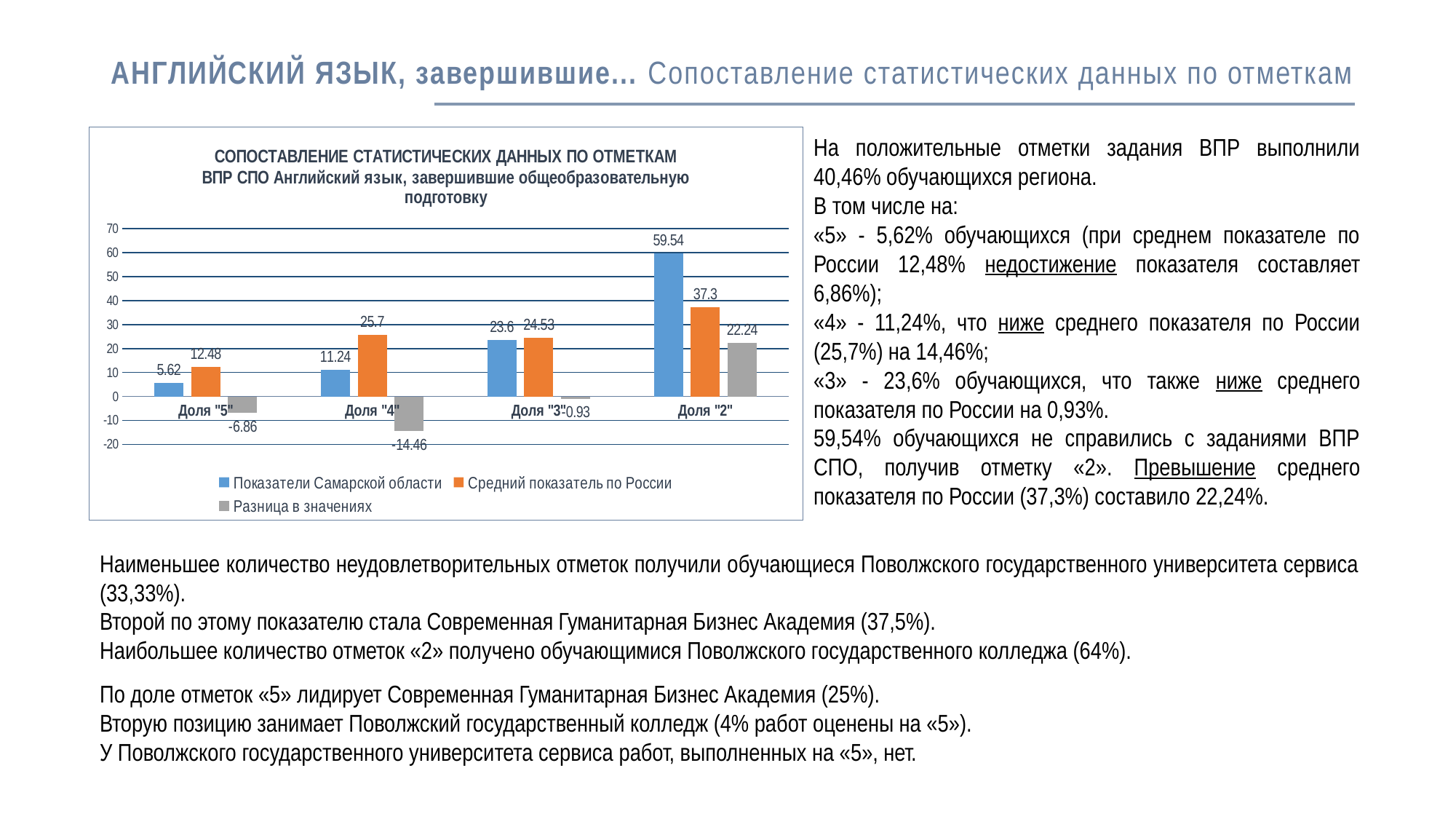
What is the value of "Показатели Самарской области" for Доля "5"? 5.62 What is the value of "Показатели Самарской области" for Доля "2"? 59.54 Which category has the highest value for "Показатели Самарской области"? Доля "2" What is the value of "Разница в значениях" for Доля "3"? -0.93 For Доля "2", which is larger: "Показатели Самарской области" or "Средний показатель по России"? Показатели Самарской области Which series is shown in orange in the chart? Средний показатель по России How many series does the chart legend list? 3 What is the value of "Средний показатель по России" for Доля "4"? 25.7 What is the difference between "Средний показатель по России" and "Показатели Самарской области" for Доля "4"? 14.46 What type of chart is shown on the slide? bar chart Which category has the lowest value for "Средний показатель по России"? Доля "5" How many categories are shown on the x axis of the chart? 4